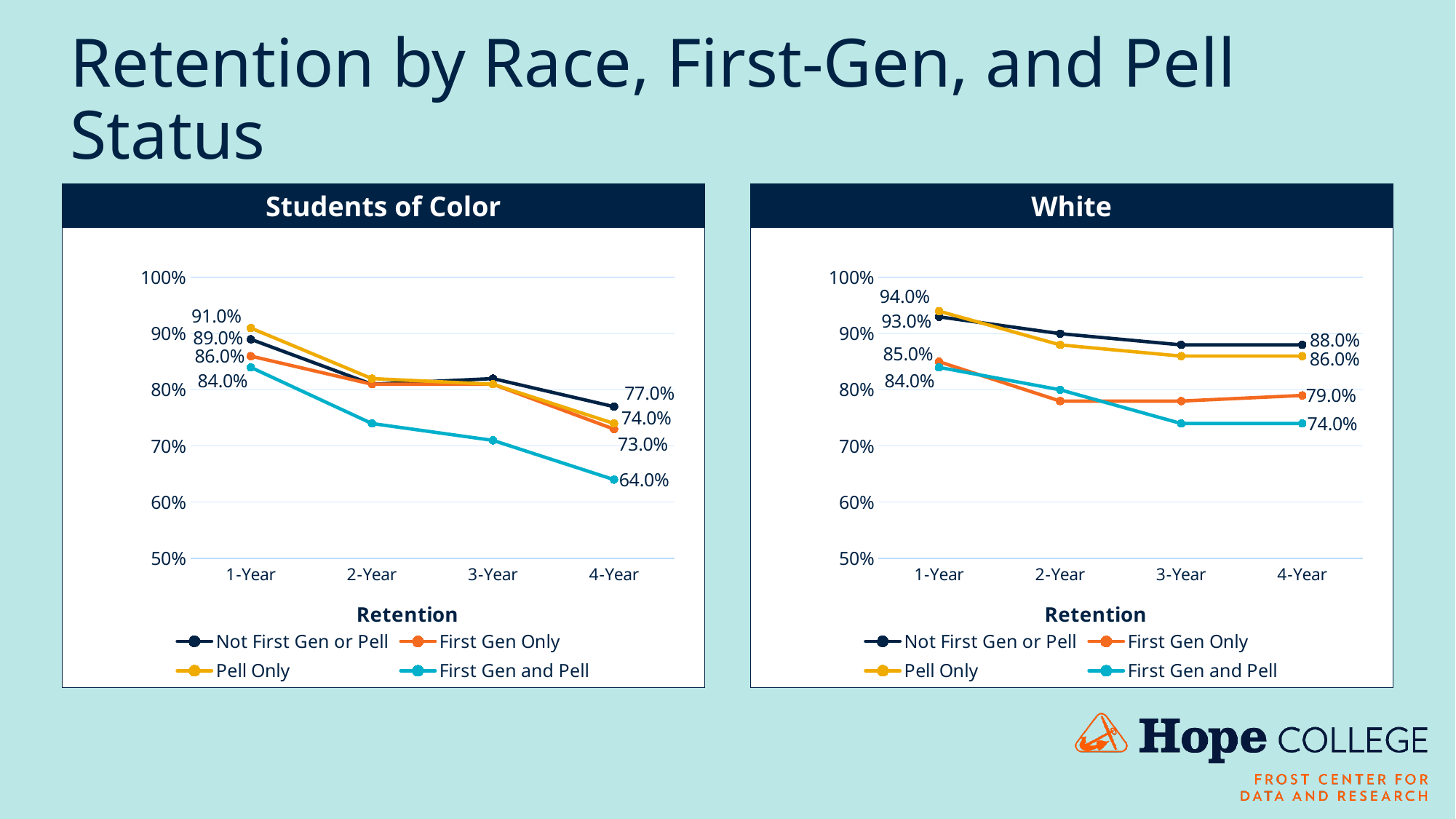
In the "Students of Color" chart, which group has the lowest 4-Year retention? First Gen and Pell In the "White" chart, which is higher at 4-Year: Not First Gen or Pell or First Gen Only? Not First Gen or Pell How many retention points are shown along the x axis of the "Students of Color" chart? 4 In the "Students of Color" chart, what is the 1-Year retention for Pell Only? 91.0% In the "Students of Color" chart, what is the difference between the 4-Year retention of Not First Gen or Pell and First Gen and Pell? 13.0% In the "Students of Color" chart, what is the 4-Year retention for First Gen and Pell? 64.0% What kind of chart is the "Students of Color" chart? Line chart In the "White" chart, what is the 4-Year retention for First Gen and Pell? 74.0% In the "White" chart, what is the 4-Year retention for Not First Gen or Pell? 88.0% How many series does the legend of the "White" chart list? 4 In the "Students of Color" chart, what is the 4-Year retention for Not First Gen or Pell? 77.0% In the "Students of Color" chart, is the 2-Year retention for First Gen and Pell greater or less than 80%? less